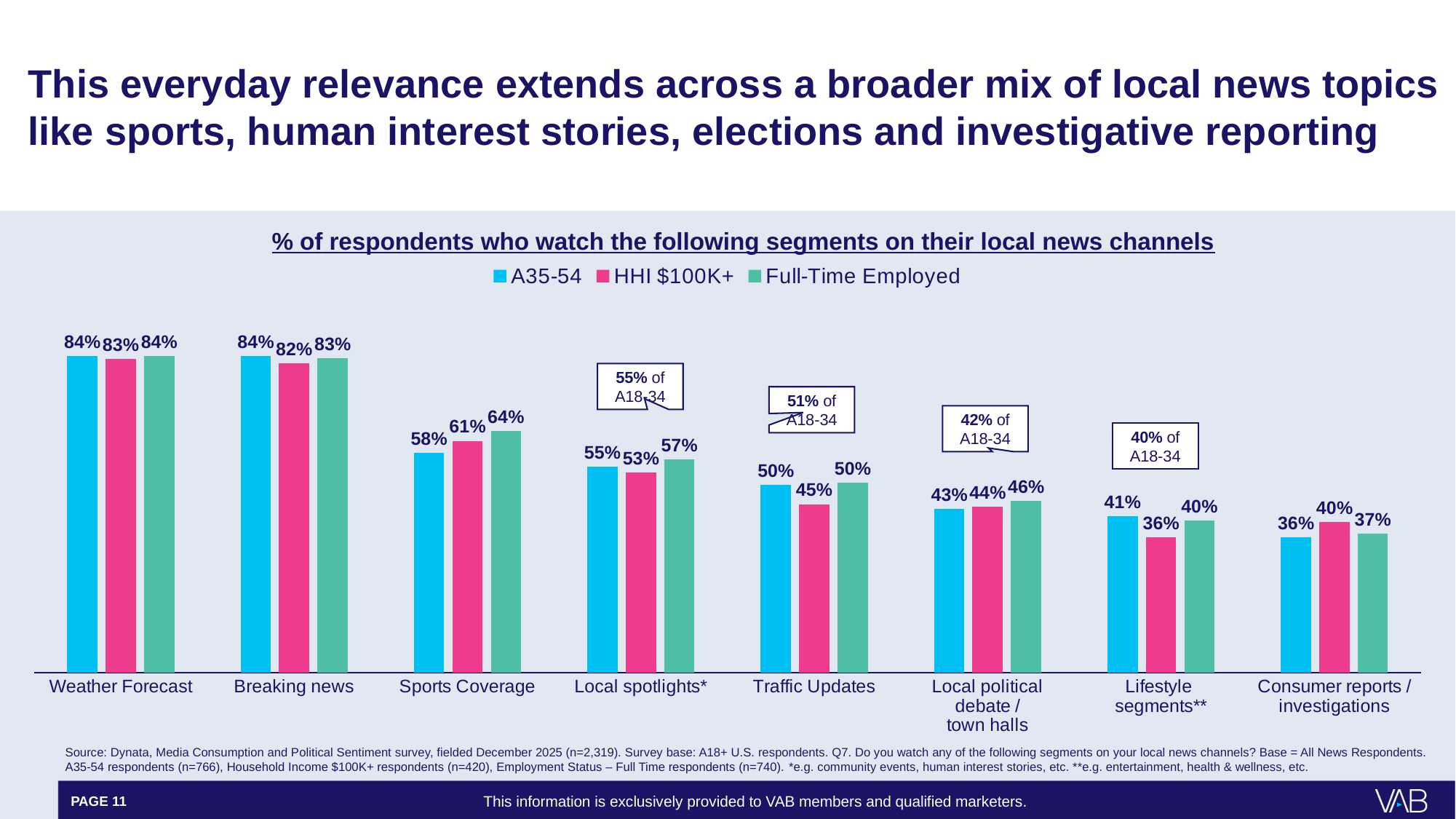
How many series does the legend list? 3 What is the value for HHI $100K+ respondents for Traffic Updates? 45% How many segments (categories) are shown on the x axis? 8 What kind of chart is shown on the slide? Bar chart What is the value for HHI $100K+ respondents for Lifestyle segments**? 36% What percentage of Full-Time Employed respondents watch Consumer reports / investigations? 37% According to the callout box, what percentage of A18-34 respondents watch Traffic Updates? 51% For Lifestyle segments**, which is larger: the A35-54 value or the HHI $100K+ value? A35-54 What is the difference between the Full-Time Employed and A35-54 values for Sports Coverage? 6 percentage points Which segment has the highest value for Full-Time Employed respondents? Weather Forecast Which segment has the lowest value for A35-54 respondents? Consumer reports / investigations What percentage of A35-54 respondents watch Sports Coverage on their local news channels? 58%